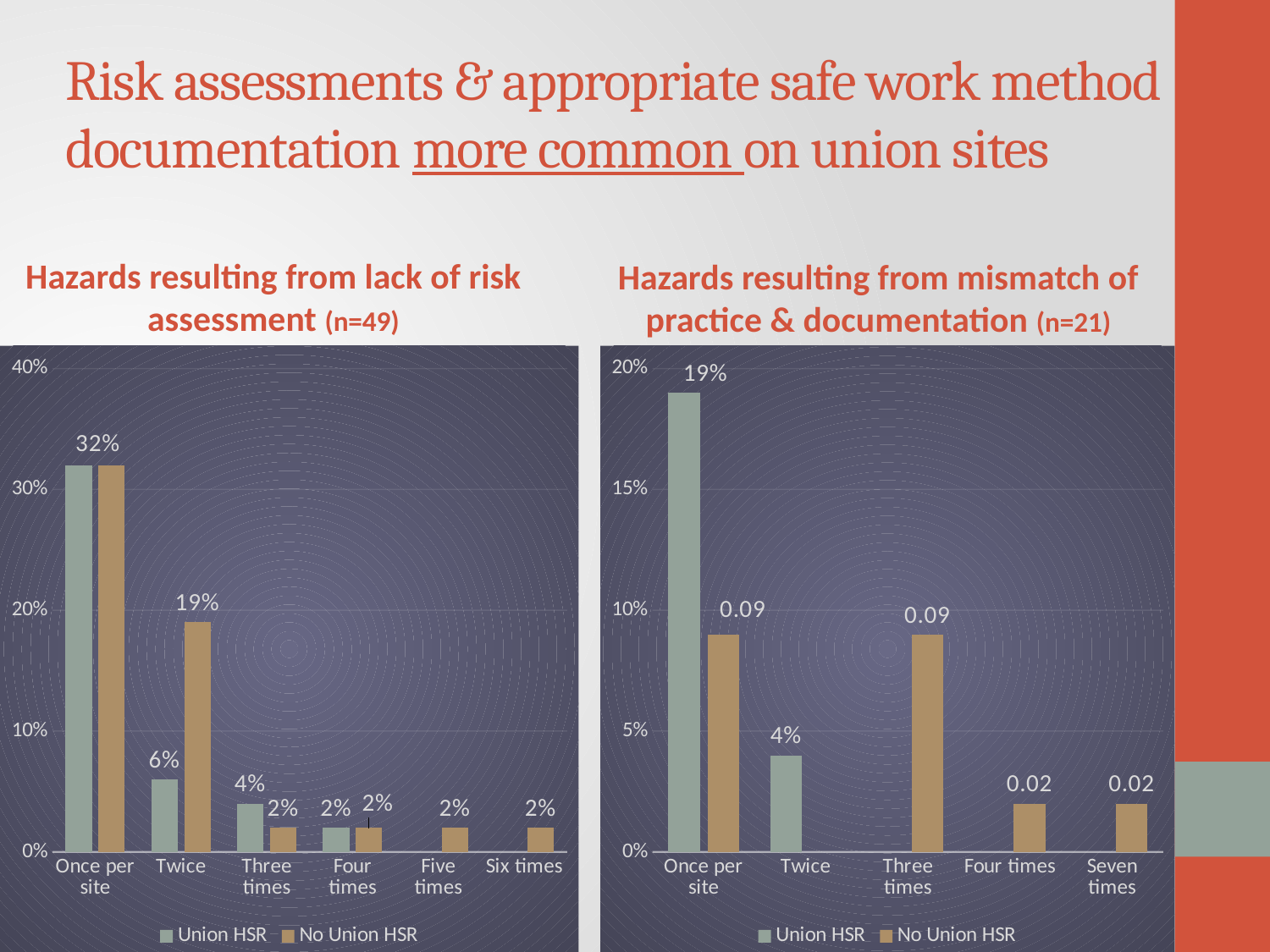
In the left chart, 'Hazards resulting from lack of risk assessment', what is the difference between the No Union HSR and Union HSR values for Twice? 13 percentage points What kind of chart is the left chart, 'Hazards resulting from lack of risk assessment'? bar chart In the left chart, 'Hazards resulting from lack of risk assessment', what is the Union HSR value for Three times? 4% In the left chart, 'Hazards resulting from lack of risk assessment', which series has the larger value for Twice? No Union HSR In the right chart, 'Hazards resulting from mismatch of practice & documentation', what is the No Union HSR value for Three times? 0.09 In the left chart, 'Hazards resulting from lack of risk assessment', what is the Union HSR value for Twice? 6% In the right chart, 'Hazards resulting from mismatch of practice & documentation', what is the Union HSR value for Once per site? 19% In the left chart, 'Hazards resulting from lack of risk assessment', what value is labelled for Once per site? 32% In the right chart, 'Hazards resulting from mismatch of practice & documentation', how many categories are on the x axis? 5 How many series does the legend of the right chart, 'Hazards resulting from mismatch of practice & documentation', list? 2 In the left chart, 'Hazards resulting from lack of risk assessment', what is the No Union HSR value for Twice? 19% In the left chart, 'Hazards resulting from lack of risk assessment', how many categories are on the x axis? 6